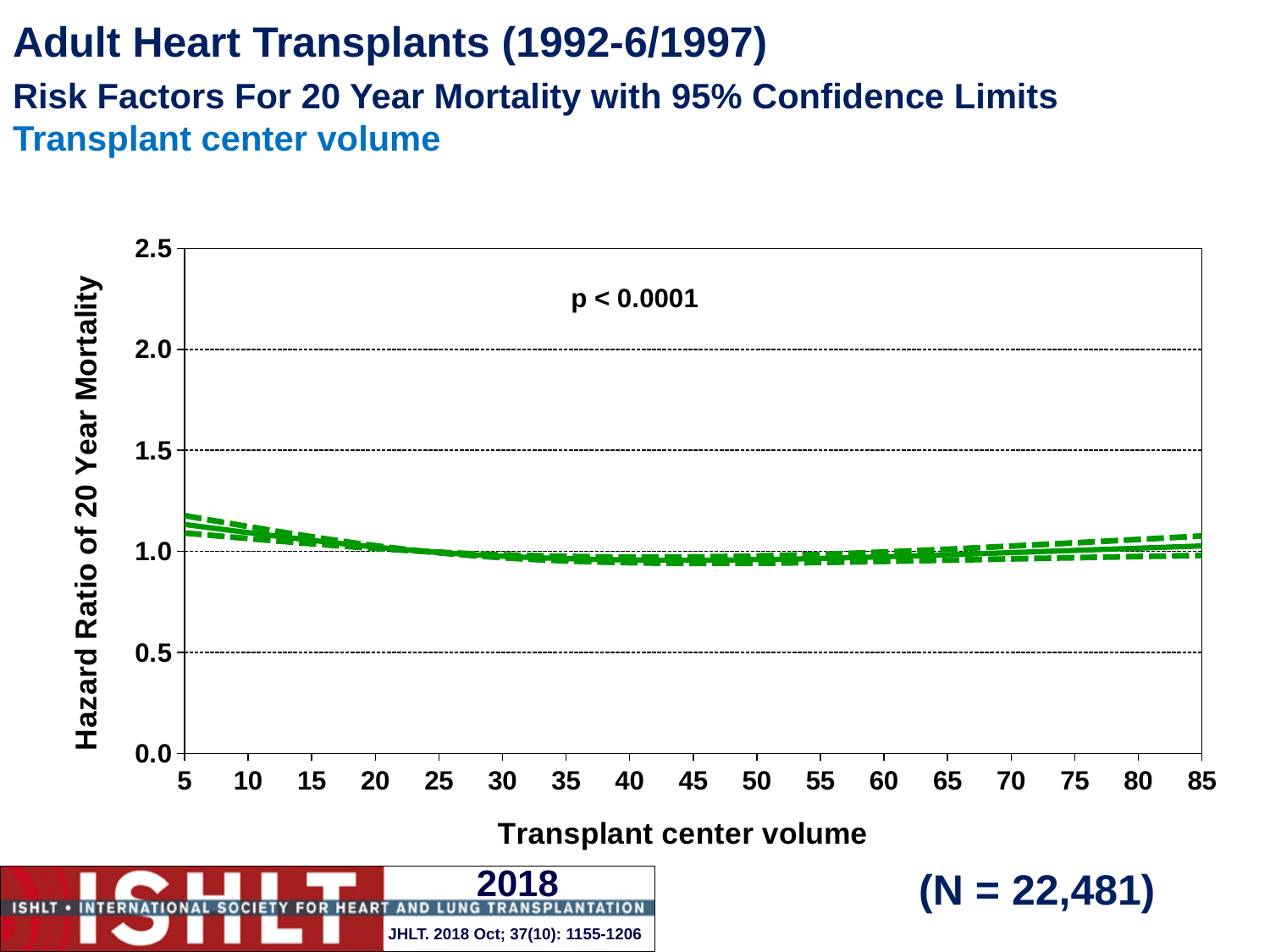
How many tick labels are shown on the x axis? 17 Is the hazard ratio at a transplant center volume of 85 greater or less than 1.5? less What is the title of the x axis? Transplant center volume What p-value is printed on the chart? p < 0.0001 Does the hazard ratio rise or fall as transplant center volume increases from 5 to 40? fall What kind of chart is shown on the slide? line chart At which transplant center volume on the x axis is the hazard ratio highest? 5 Is the hazard ratio at a transplant center volume of 45 greater or less than 1.5? less What is the highest value labelled on the y axis? 2.5 Is the hazard ratio at a transplant center volume of 5 greater or less than 1.0? greater What is the title of the y axis? Hazard Ratio of 20 Year Mortality What is the sample size (N) shown on the slide? N = 22,481